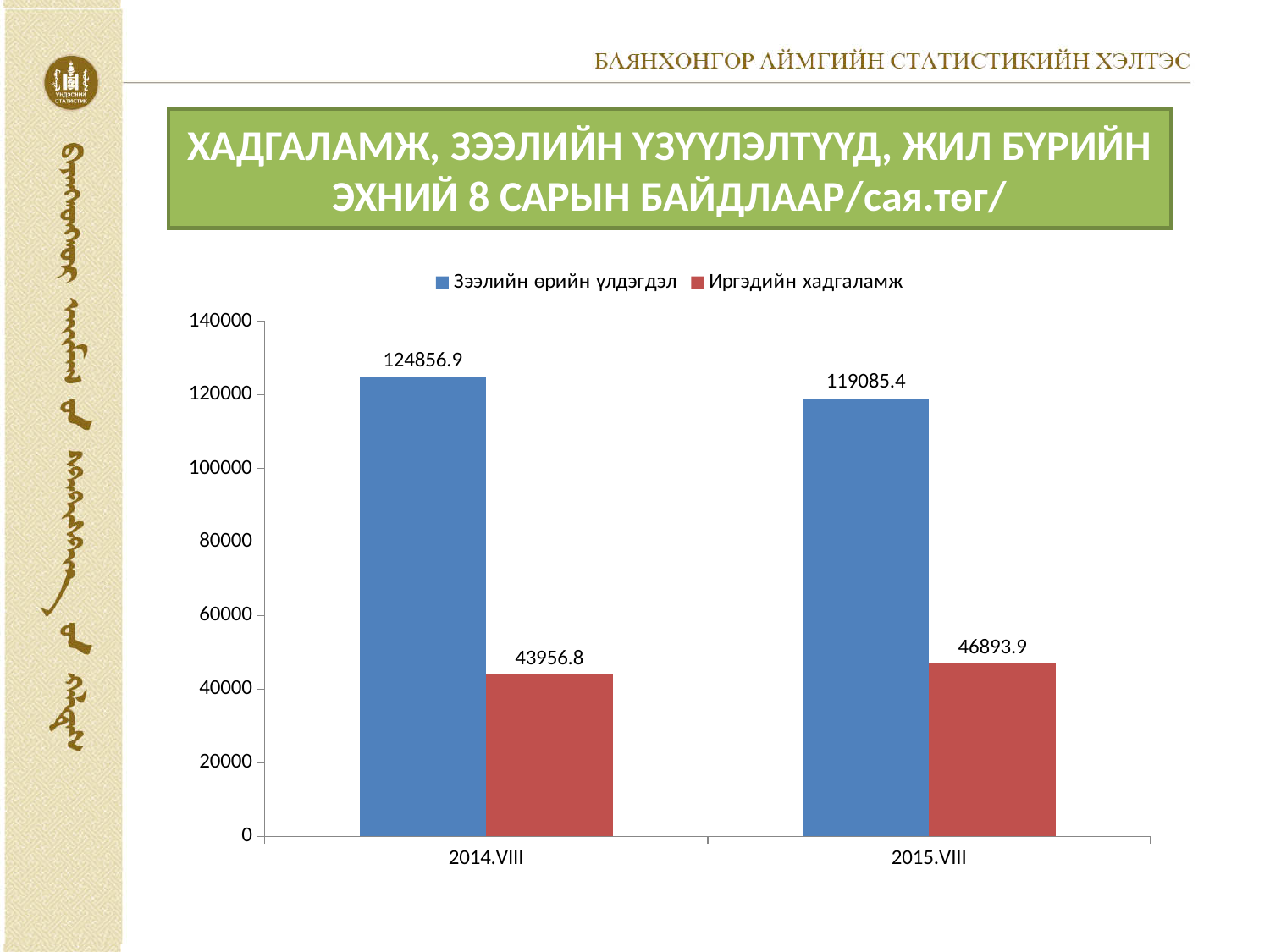
What is the value of Иргэдийн хадгаламж for 2014.VIII? 43956.8 In which period is Иргэдийн хадгаламж lowest? 2014.VIII In which period is Зээлийн өрийн үлдэгдэл highest? 2014.VIII What kind of chart is shown on the slide? Bar chart What is the value of Зээлийн өрийн үлдэгдэл for 2014.VIII? 124856.9 What is the value of Зээлийн өрийн үлдэгдэл for 2015.VIII? 119085.4 Does Зээлийн өрийн үлдэгдэл rise or fall from 2014.VIII to 2015.VIII? Fall What is the value of Иргэдийн хадгаламж for 2015.VIII? 46893.9 How many series does the legend list? 2 Which is larger in 2015.VIII: Зээлийн өрийн үлдэгдэл or Иргэдийн хадгаламж? Зээлийн өрийн үлдэгдэл What is the difference between Зээлийн өрийн үлдэгдэл in 2014.VIII and 2015.VIII? 5771.5 What is the difference between Иргэдийн хадгаламж in 2015.VIII and 2014.VIII? 2937.1